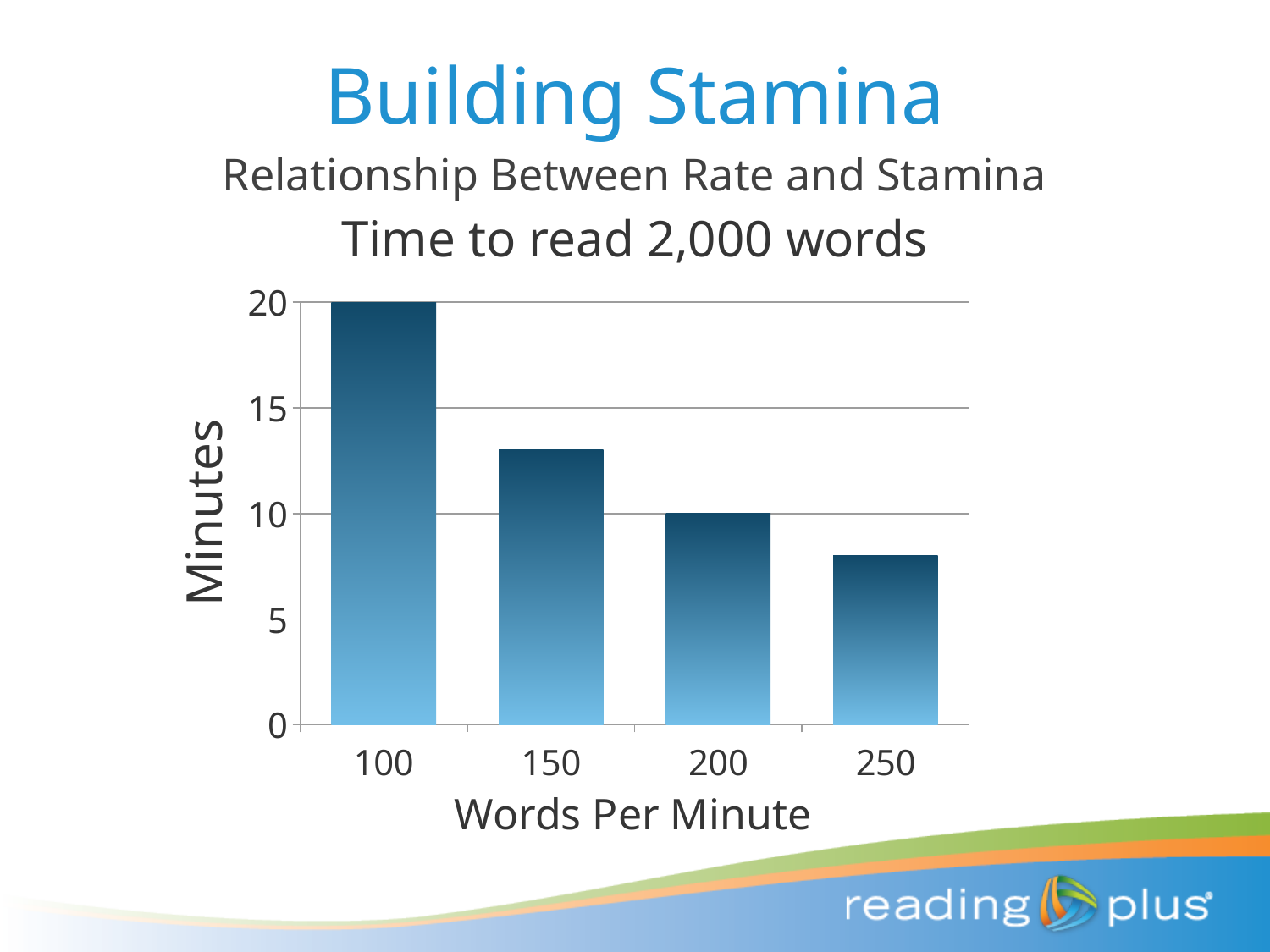
Is the value for 250 words per minute greater or less than 10 minutes? less How many bars (words-per-minute categories) are plotted in the chart? 4 What is the label of the vertical axis of the chart? Minutes Is the value for 150 words per minute greater or less than 15 minutes? less Which words-per-minute rate has the lowest number of minutes? 250 Do the minutes rise or fall as words per minute increases along the x axis? fall How many minutes does it take to read 2,000 words at 100 words per minute? 20 Which words-per-minute rate has the highest number of minutes? 100 How many minutes does it take to read 2,000 words at 200 words per minute? 10 What type of chart is shown on the slide? bar chart Which takes more minutes: reading at 150 words per minute or at 200 words per minute? 150 What is the difference in minutes between reading at 100 words per minute and at 200 words per minute? 10